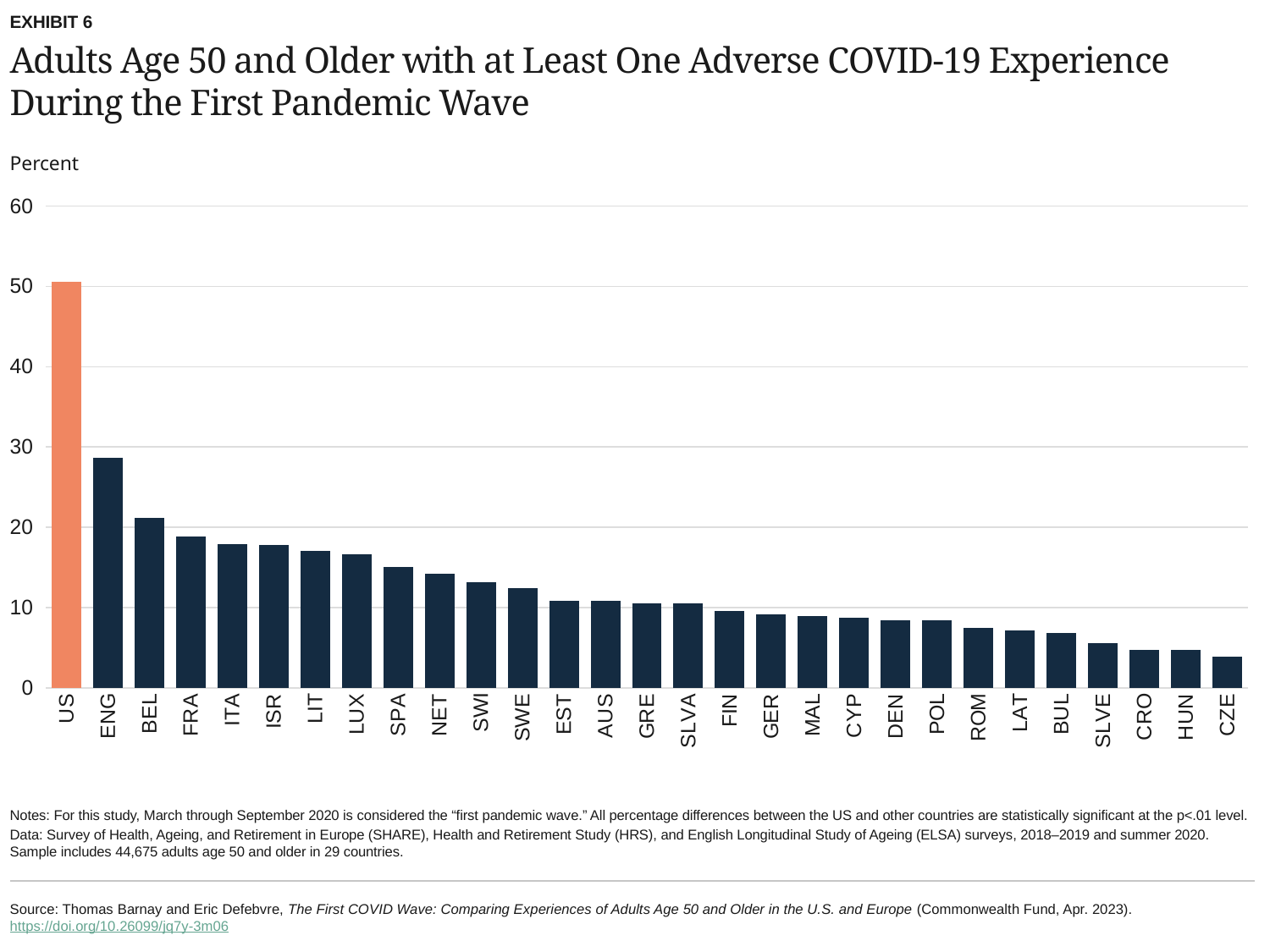
Is the value for SWE greater or less than 10? greater Is the value for ENG greater or less than 30? less Which country has the lowest percentage in the chart? CZE Do the values rise or fall moving from left to right along the x axis? fall Which has a larger value, ENG or BEL? ENG Is the value for US greater or less than 40? greater Which country has the highest percentage of adults age 50 and older with at least one adverse COVID-19 experience? US How many countries are shown on the x axis of the chart? 29 Which bar is shown in a different colour (orange) from the rest? US What kind of chart is shown on the slide? bar chart